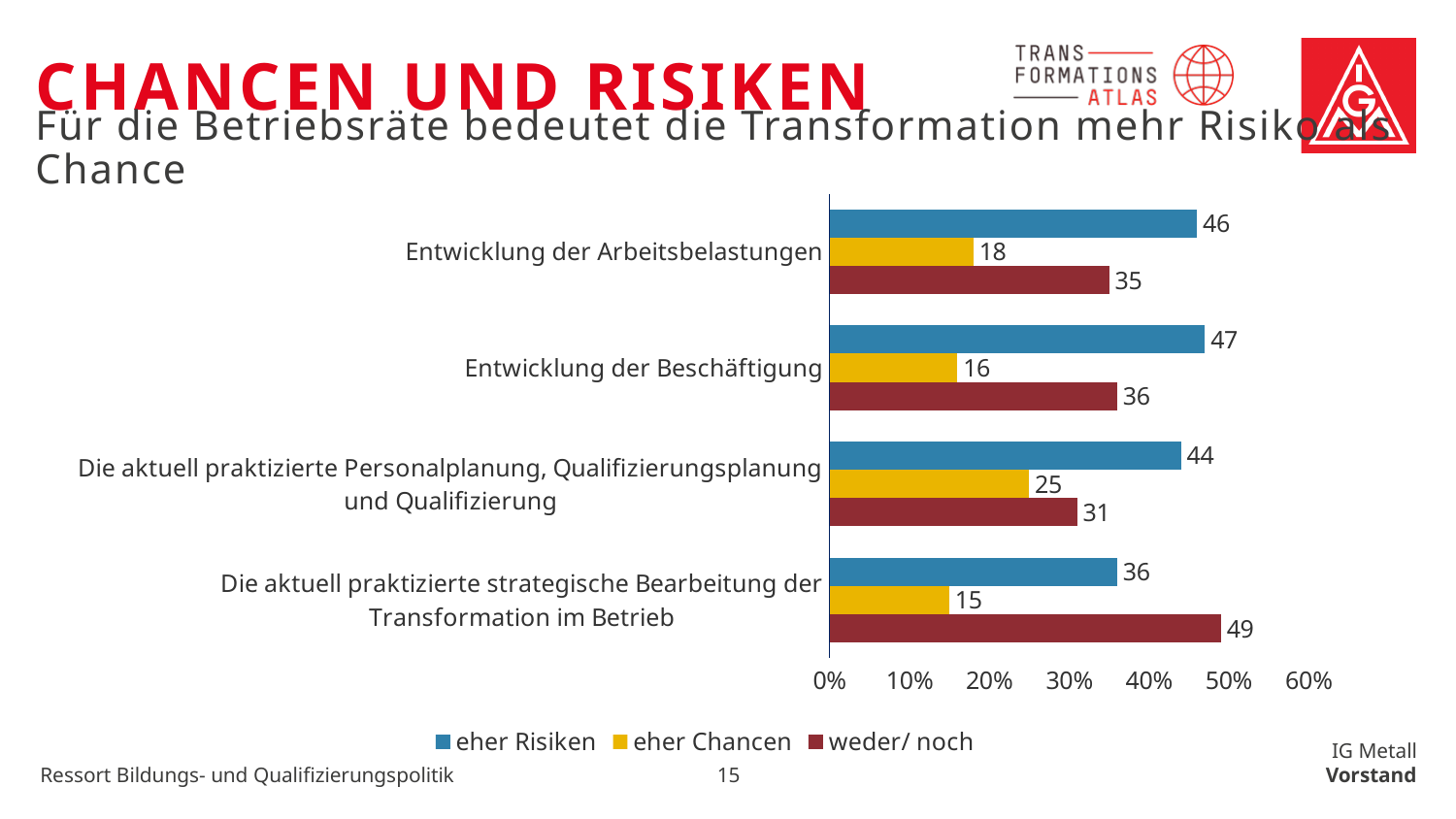
How many series does the legend list? 3 How many categories are shown on the chart? 4 What kind of chart is shown on the slide? Bar chart What is the value for "eher Risiken" for "Entwicklung der Arbeitsbelastungen"? 46 What is the value for "eher Chancen" for "Entwicklung der Beschäftigung"? 16 What is the difference between the "eher Risiken" and "eher Chancen" values for "Entwicklung der Beschäftigung"? 31 For "Die aktuell praktizierte strategische Bearbeitung der Transformation im Betrieb", which is larger: "eher Risiken" or "weder/ noch"? weder/ noch Is the "weder/ noch" value for "Entwicklung der Arbeitsbelastungen" greater or less than 30%? greater What is the value for "weder/ noch" for "Die aktuell praktizierte strategische Bearbeitung der Transformation im Betrieb"? 49 Which category has the lowest value for "eher Risiken"? Die aktuell praktizierte strategische Bearbeitung der Transformation im Betrieb Which category has the highest value for "eher Chancen"? Die aktuell praktizierte Personalplanung, Qualifizierungsplanung und Qualifizierung Which colour represents the "eher Chancen" series? Yellow